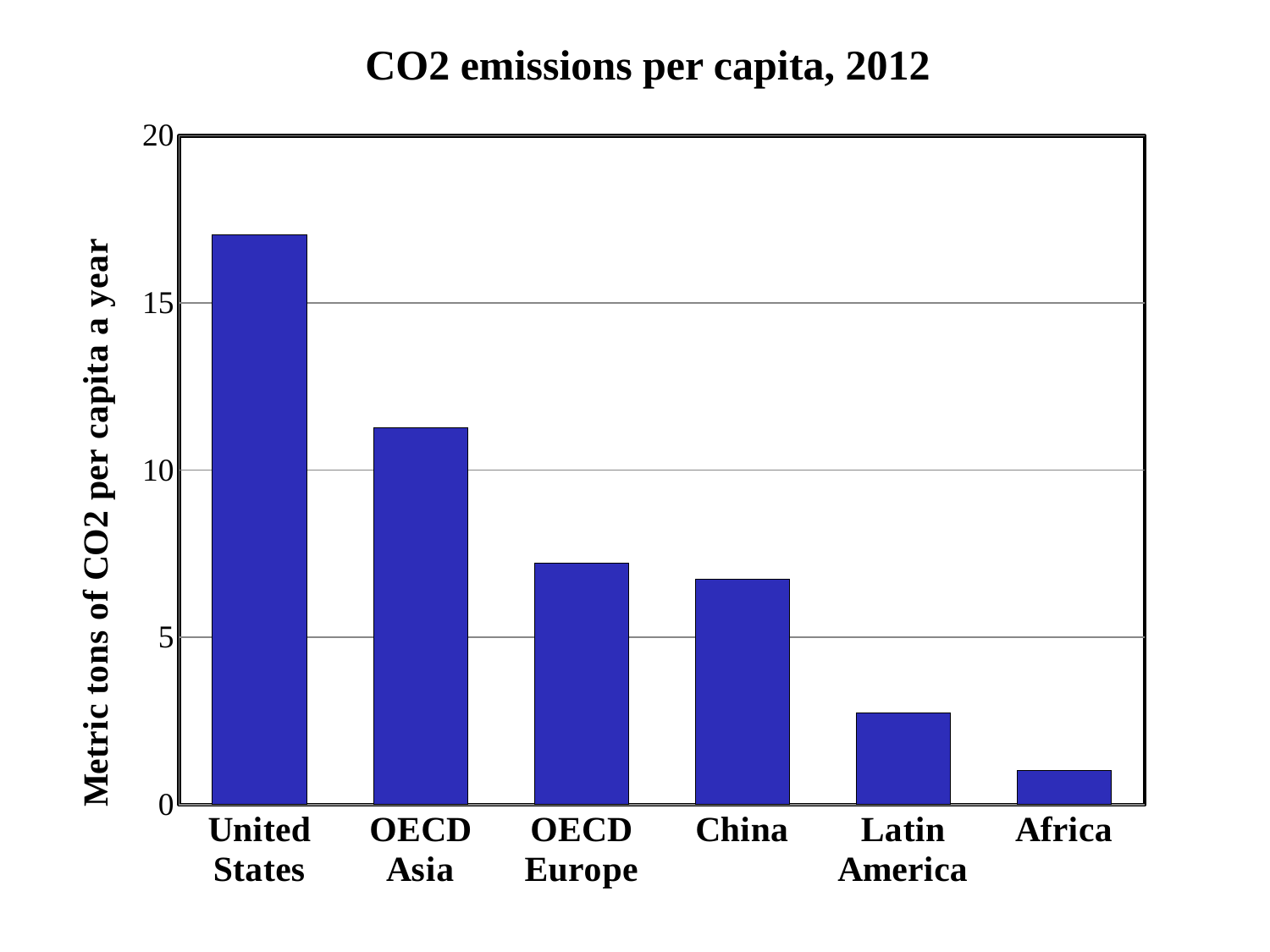
Do the values rise or fall moving from left to right along the x axis? fall What type of chart is shown on the slide? bar chart Is the value for Latin America greater or less than 5? less Which category has the lowest CO2 emissions per capita? Africa How many categories are plotted on the x axis? 6 Which category has the highest CO2 emissions per capita? United States What is the title of the chart? CO2 emissions per capita, 2012 Is the value for OECD Asia greater or less than 10? greater Which is larger, the value for Latin America or the value for Africa? Latin America Is the value for United States greater or less than 15? greater Which is larger, the value for United States or the value for OECD Asia? United States